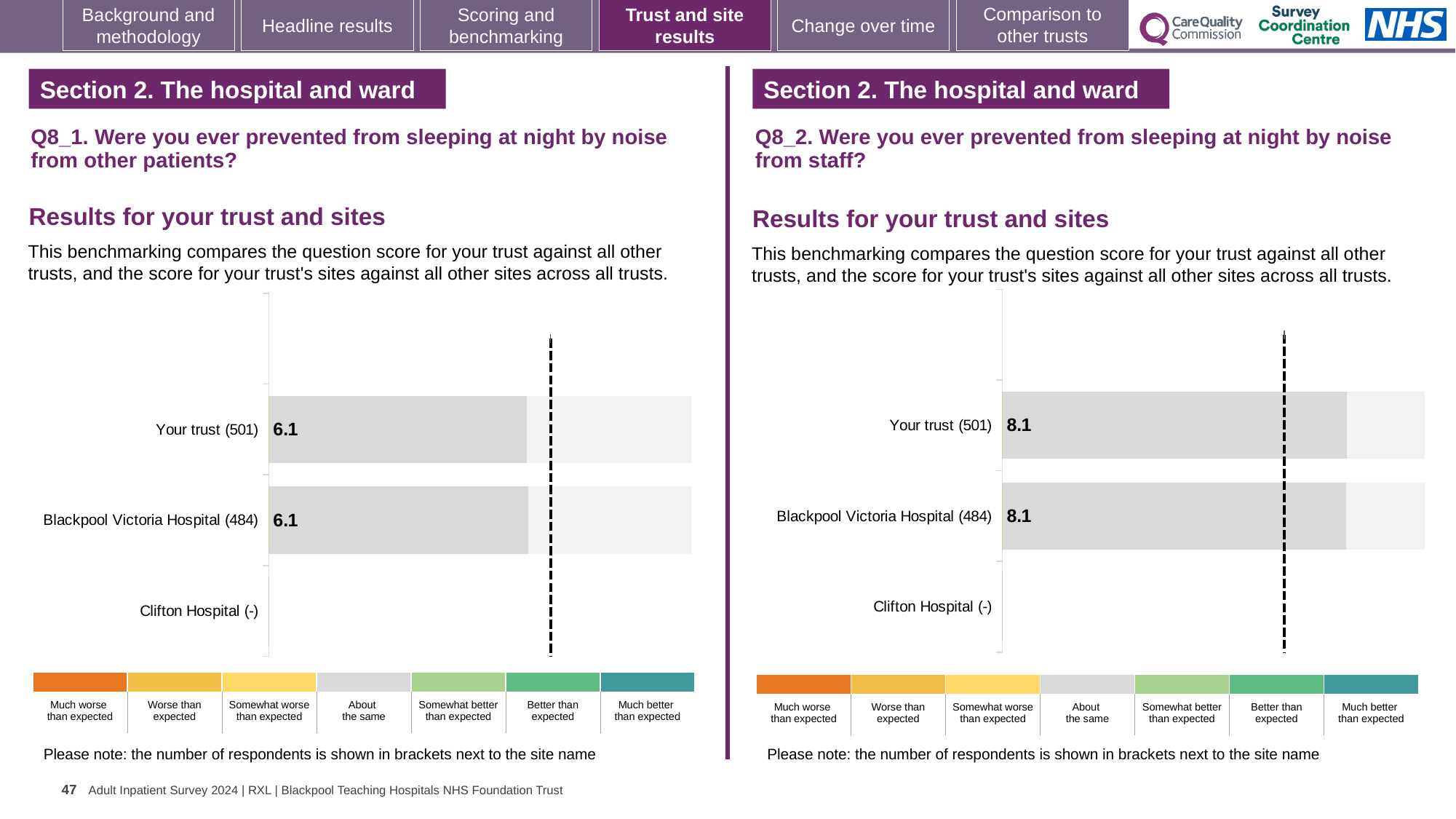
How many categories are listed on the Q8_1 chart (left)? 3 What is the difference between the Your trust score on the Q8_2 chart (right) and the Your trust score on the Q8_1 chart (left)? 2.0 How many categories are listed on the Q8_2 chart (right)? 3 How many rating bands are shown in the colour key below the Q8_2 chart (right)? 7 On the Q8_2 chart (right), what is the score for Your trust (501)? 8.1 On the Q8_1 chart (left), what is the score for Your trust (501)? 6.1 On the Q8_1 chart (left), which category has no bar plotted? Clifton Hospital (-) What kind of chart is used on the Q8_1 chart (left)? Bar chart On the Q8_1 chart (left), what is the score for Blackpool Victoria Hospital (484)? 6.1 On the Q8_2 chart (right), what is the score for Blackpool Victoria Hospital (484)? 8.1 Which is larger: the Blackpool Victoria Hospital score on the Q8_1 chart (left) or on the Q8_2 chart (right)? Q8_2 chart (right)